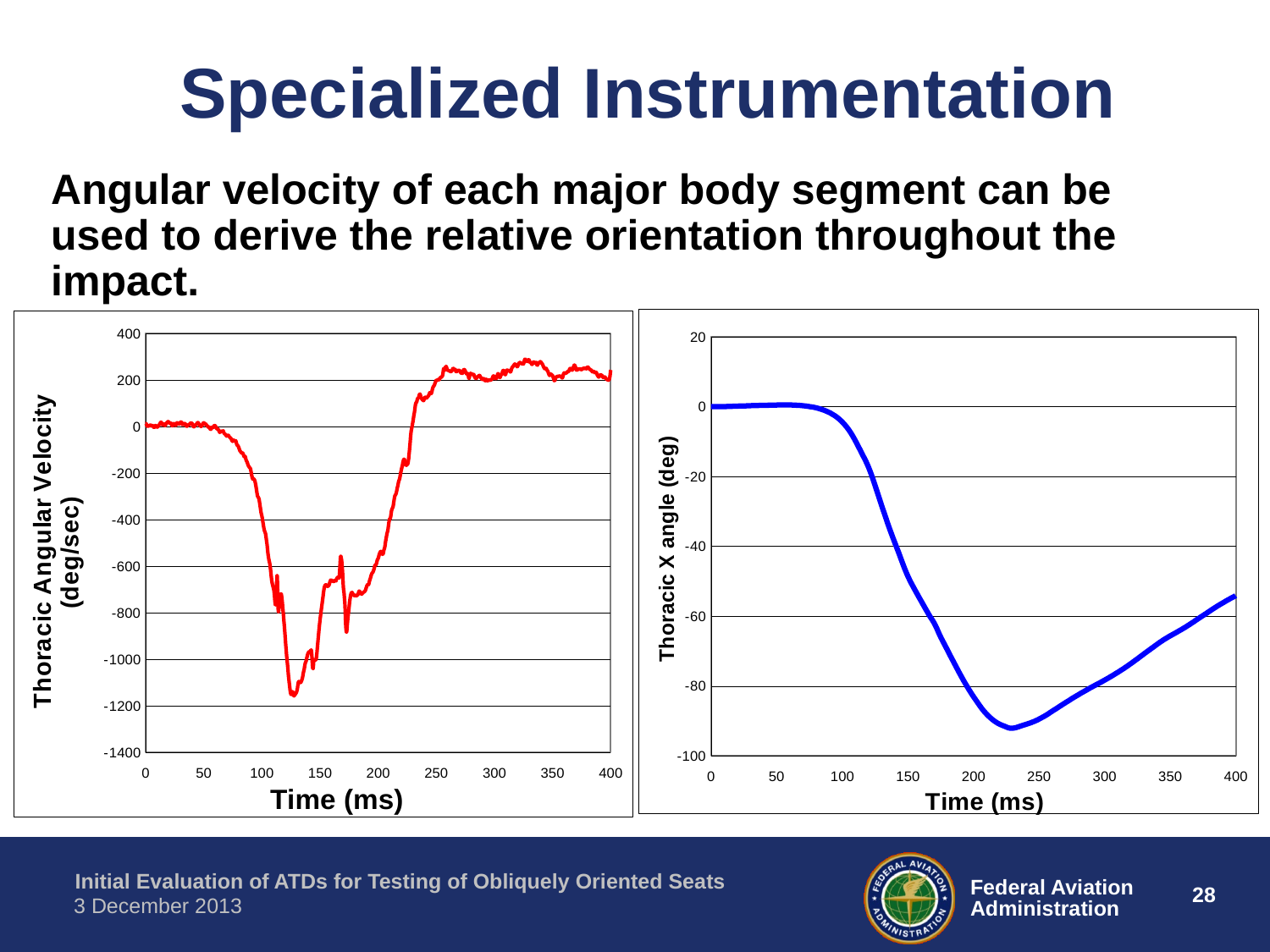
In the right chart, does the Thoracic X angle rise or fall between 100 ms and 200 ms? fall What is the y-axis label of the left chart? Thoracic Angular Velocity (deg/sec) In the left chart, does the angular velocity rise or fall between 50 ms and 125 ms? fall What is the y-axis label of the right chart? Thoracic X angle (deg) In the left chart, is the value at 300 ms greater or less than 0? greater In the right chart, is the value at 50 ms greater or less than -20? greater What kind of chart is the right chart on the slide? line chart In the right chart, is the value at 230 ms greater or less than -80? less What kind of chart is the left chart on the slide? line chart In the right chart, does the Thoracic X angle rise or fall between 250 ms and 400 ms? rise